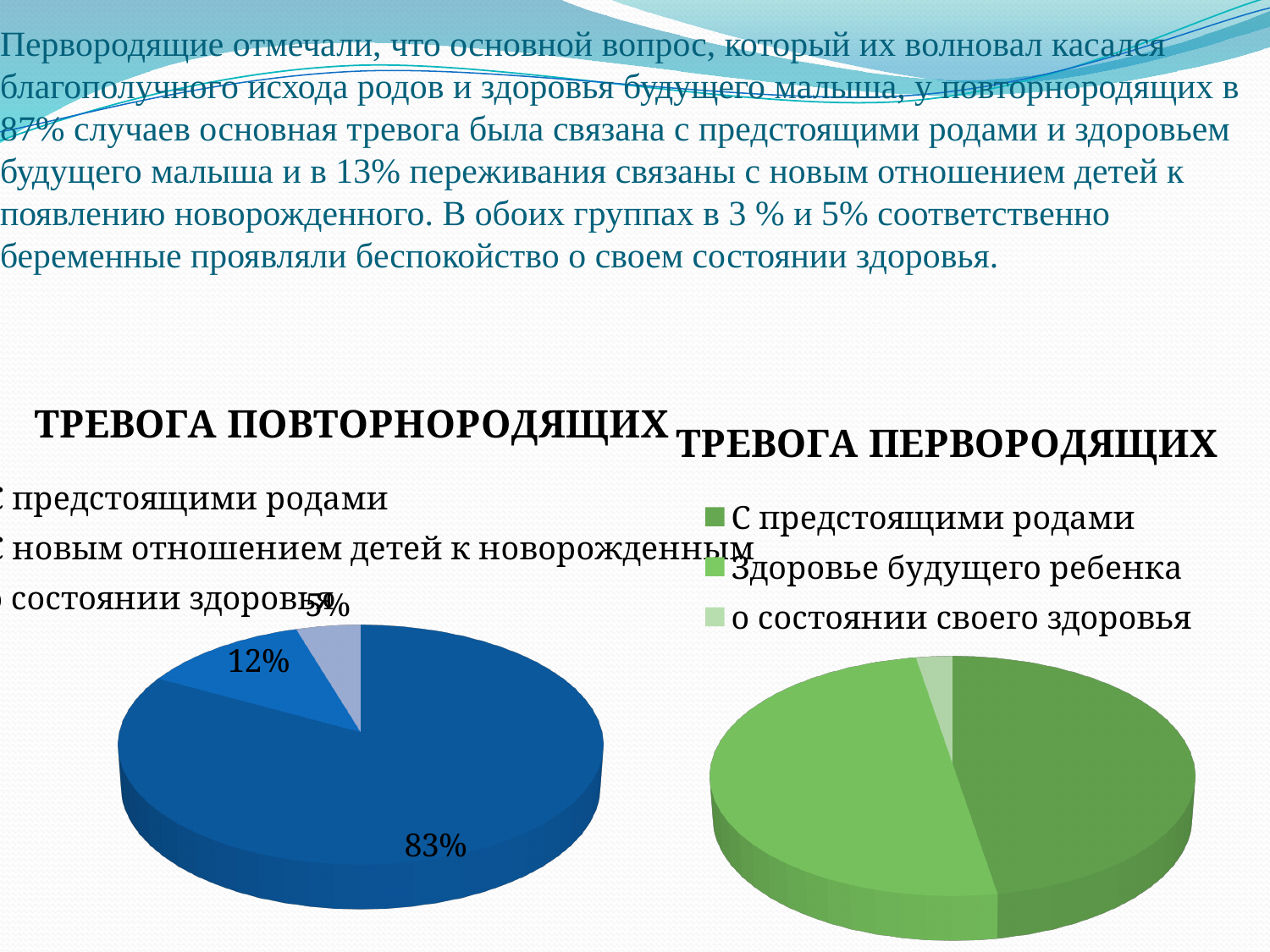
In the 'ТРЕВОГА ПОВТОРНОРОДЯЩИХ' chart, which is larger: 'С предстоящими родами' or 'С новым отношением детей к новорожденным'? С предстоящими родами How many slices does the 'ТРЕВОГА ПЕРВОРОДЯЩИХ' chart have? 3 What kind of chart is the 'ТРЕВОГА ПОВТОРНОРОДЯЩИХ' chart on the left? Pie chart In the 'ТРЕВОГА ПОВТОРНОРОДЯЩИХ' chart, which category has the smallest slice? о состоянии здоровья How many entries does the legend of the 'ТРЕВОГА ПЕРВОРОДЯЩИХ' chart list? 3 In the 'ТРЕВОГА ПОВТОРНОРОДЯЩИХ' chart, which category has the largest slice? С предстоящими родами What is the title of the chart on the right side of the slide? ТРЕВОГА ПЕРВОРОДЯЩИХ In the 'ТРЕВОГА ПОВТОРНОРОДЯЩИХ' chart, what is the difference between the 83% slice and the 12% slice? 71% In the 'ТРЕВОГА ПОВТОРНОРОДЯЩИХ' chart, what share is shown for 'С новым отношением детей к новорожденным'? 12% What kind of chart is the 'ТРЕВОГА ПЕРВОРОДЯЩИХ' chart on the right? Pie chart In the 'ТРЕВОГА ПЕРВОРОДЯЩИХ' chart, which category has the smallest slice? о состоянии своего здоровья In the 'ТРЕВОГА ПОВТОРНОРОДЯЩИХ' chart, what share is shown for the largest slice? 83%